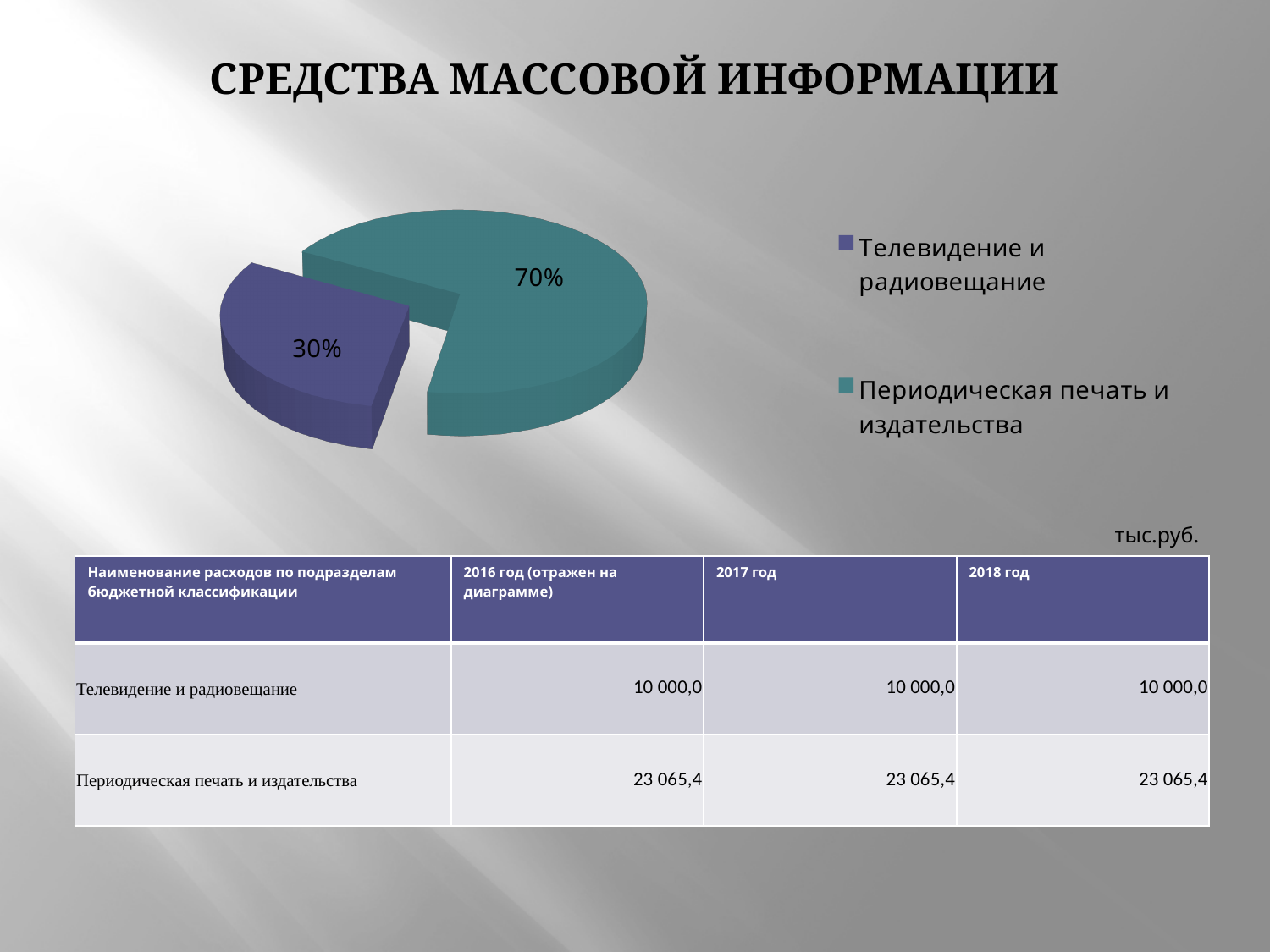
What kind of chart is shown on the slide? Pie chart Which is larger: the share for Телевидение и радиовещание or the share for Периодическая печать и издательства? Периодическая печать и издательства What is the title of the slide containing the pie chart? СРЕДСТВА МАССОВОЙ ИНФОРМАЦИИ Which category has the largest slice of the pie? Периодическая печать и издательства How many entries does the chart legend list? 2 What share of the pie does Телевидение и радиовещание represent? 30% What share of the pie does Периодическая печать и издательства represent? 70% By how many percentage points does the share of Периодическая печать и издательства exceed that of Телевидение и радиовещание? 40 percentage points What colour is the slice for Телевидение и радиовещание? Purple How many slices does the pie chart have? 2 Which category has the smallest slice of the pie? Телевидение и радиовещание